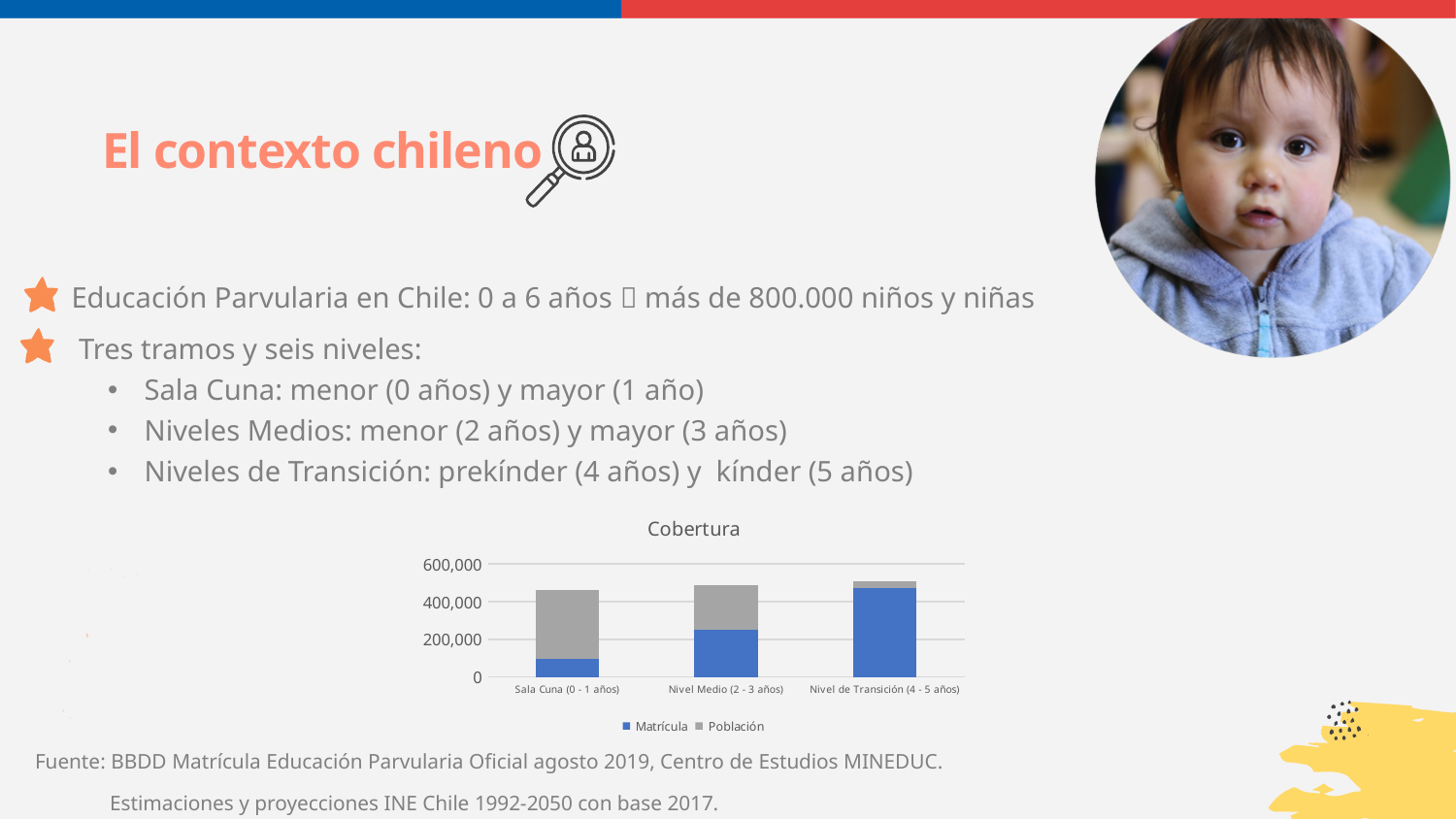
How many series does the chart's legend list? 2 Is the Matrícula value for Nivel Medio (2 - 3 años) greater or less than 200,000? greater Which category has the highest Matrícula value? Nivel de Transición (4 - 5 años) Does the Matrícula value rise or fall from Sala Cuna to Nivel de Transición along the x axis? Rise Which series are listed in the chart's legend? Matrícula and Población What kind of chart is shown on the slide? Stacked bar chart Is the Matrícula value for Nivel de Transición (4 - 5 años) greater or less than 400,000? greater What is the title of the chart? Cobertura How many categories are shown on the x axis of the chart? 3 Which category has the lowest Matrícula value? Sala Cuna (0 - 1 años) Is the Matrícula value for Sala Cuna (0 - 1 años) greater or less than 200,000? less Which is larger, the Matrícula value for Nivel Medio (2 - 3 años) or for Sala Cuna (0 - 1 años)? Nivel Medio (2 - 3 años)